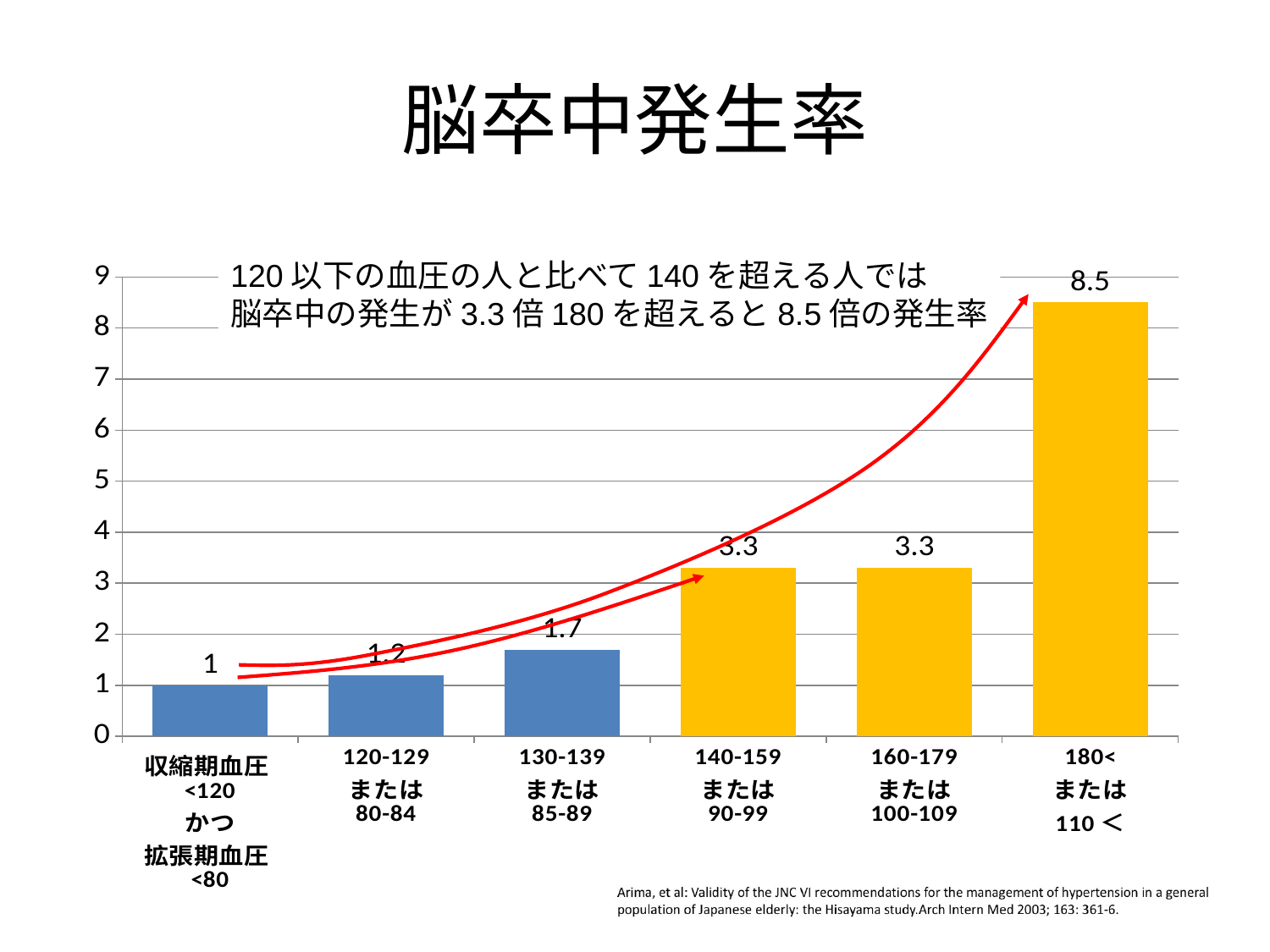
What is the difference between the value for 180< または 110< and the value for 160-179 または 100-109? 5.2 How many categories are shown on the x axis? 6 Which category has the highest value? 180< または 110< What is the value for the 130-139 または 85-89 category? 1.7 What is the difference between the value for 140-159 または 90-99 and the value for 130-139 または 85-89? 1.6 What is the stroke incidence value for the 180< または 110< category? 8.5 What kind of chart is shown on the slide? Bar chart Which category has the lowest value? 収縮期血圧<120 かつ 拡張期血圧<80 Which is larger, the value for 130-139 または 85-89 or the value for 120-129 または 80-84? 130-139 または 85-89 What is the value for the 120-129 または 80-84 category? 1.2 Do the values generally rise or fall from left to right along the x axis? Rise What is the value for the 140-159 または 90-99 category? 3.3